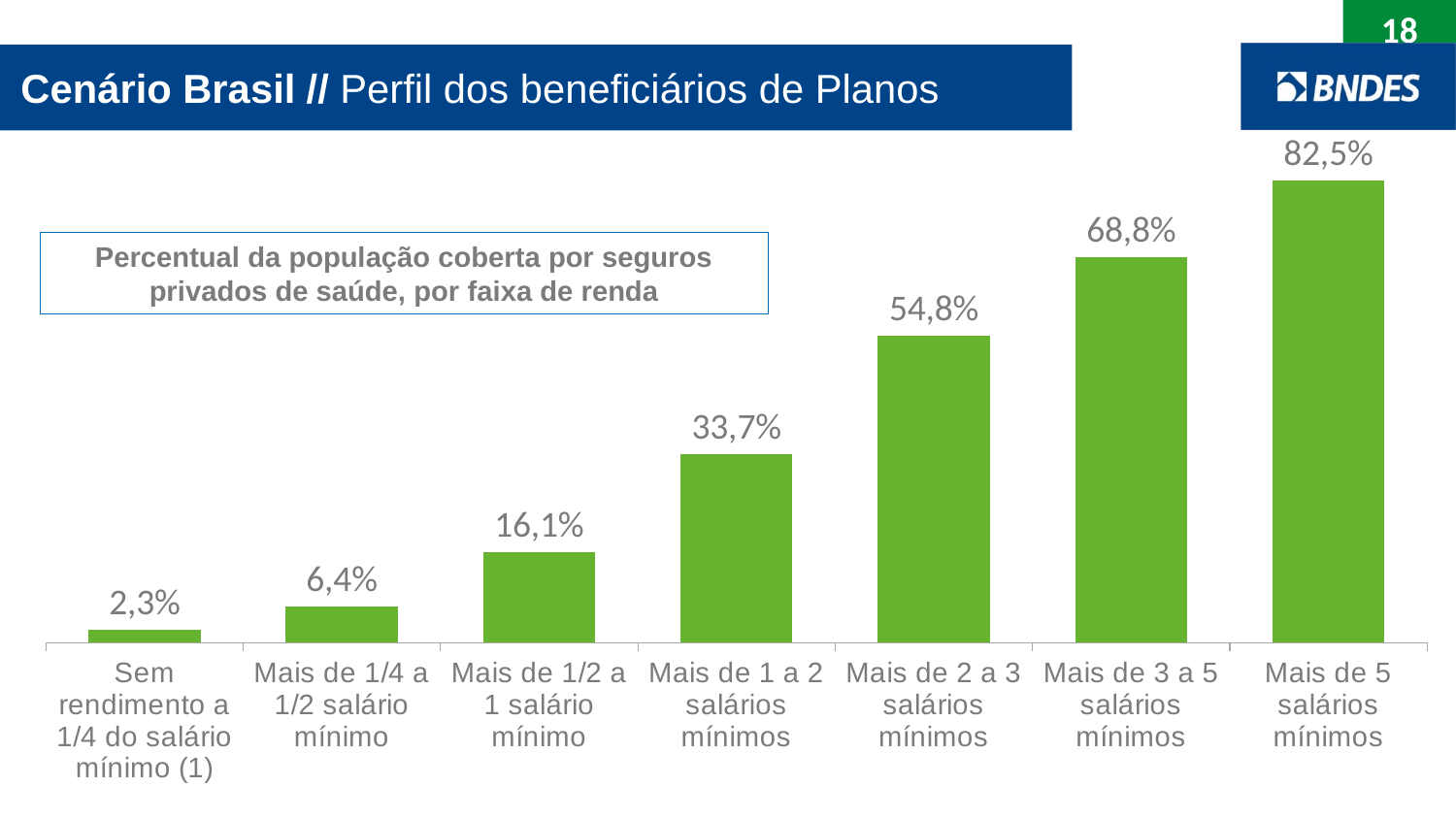
What is the title of the chart? Percentual da população coberta por seguros privados de saúde, por faixa de renda Do the values rise or fall as income brackets increase along the x axis? Rise What kind of chart is shown on the slide? Bar chart Which income bracket has the highest percentage? Mais de 5 salários mínimos What is the value for 'Sem rendimento a 1/4 do salário mínimo (1)'? 2,3% What is the difference between the values for 'Mais de 3 a 5 salários mínimos' and 'Mais de 2 a 3 salários mínimos'? 14 percentage points Which is larger: the value for 'Mais de 1/4 a 1/2 salário mínimo' or 'Mais de 1/2 a 1 salário mínimo'? Mais de 1/2 a 1 salário mínimo Which income bracket has the lowest percentage? Sem rendimento a 1/4 do salário mínimo (1) What is the value for 'Mais de 1 a 2 salários mínimos'? 33,7% How many income brackets are shown in the chart? 7 What is the value for 'Mais de 1/2 a 1 salário mínimo'? 16,1% What is the value for 'Mais de 5 salários mínimos'? 82,5%